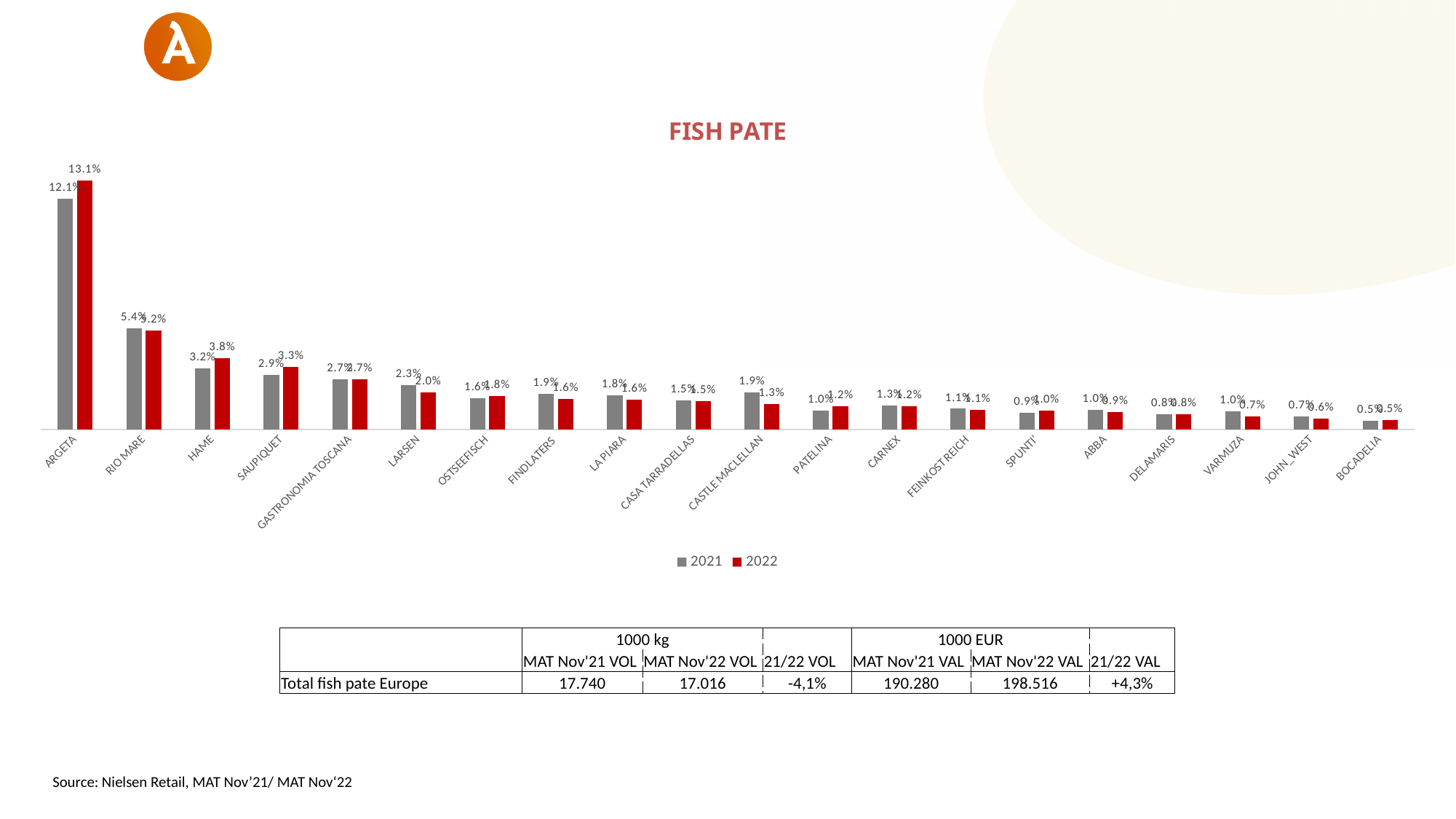
What is the 2022 value for ARGETA? 13.1% What is the 2022 value for HAME? 3.8% What type of chart is shown on the slide? bar chart How many brands (categories) are shown on the x axis of the chart? 20 Which is larger for CASTLE MACLELLAN, the 2021 value or the 2022 value? 2021 Which brand has the highest 2022 value? ARGETA What is the 2021 value for LARSEN? 2.3% What is the difference between the 2022 and 2021 values for ARGETA? 1.0% What is the difference between the 2021 and 2022 values for CASTLE MACLELLAN? 0.6% What is the 2021 value for ARGETA? 12.1% What is the title of the chart? FISH PATE How many series does the chart legend list? 2